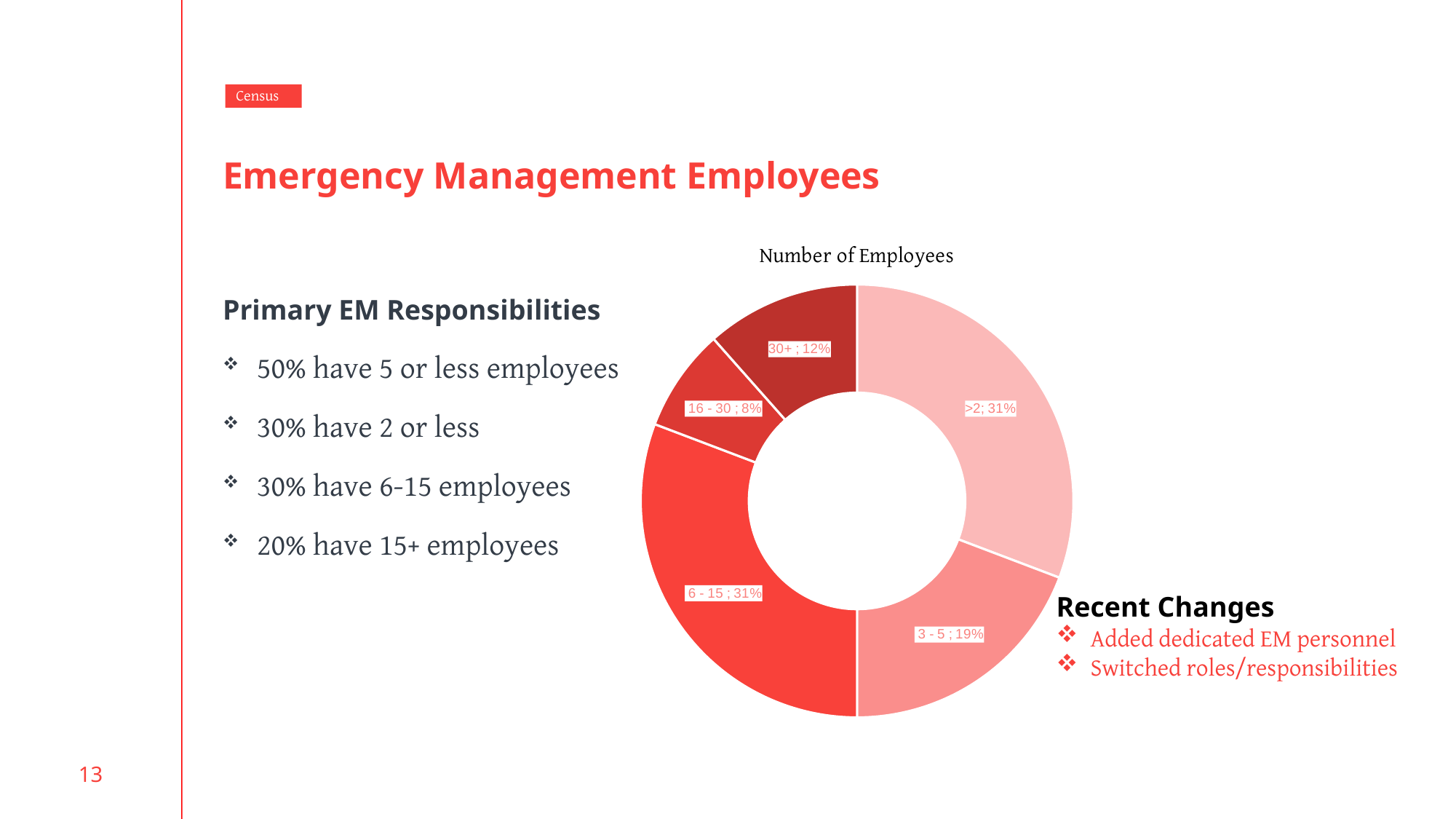
Which slice of the chart is the smallest? 16 - 30 What kind of chart is shown under the title "Number of Employees"? Doughnut (pie) chart What is the title of the chart? Number of Employees What percentage is shown for the "16 - 30" slice? 8% How many slices does the Number of Employees chart have? 5 What is the difference in percentage points between the "6 - 15" slice and the "3 - 5" slice? 12 Which slice is larger, "3 - 5" or "30+"? 3 - 5 What is the difference in percentage points between the "30+" slice and the "16 - 30" slice? 4 What share of the chart is the "3 - 5" slice? 19% What percentage is shown for the "6 - 15" slice? 31% What percentage is shown for the "30+" slice? 12% What percentage is shown for the ">2" slice? 31%